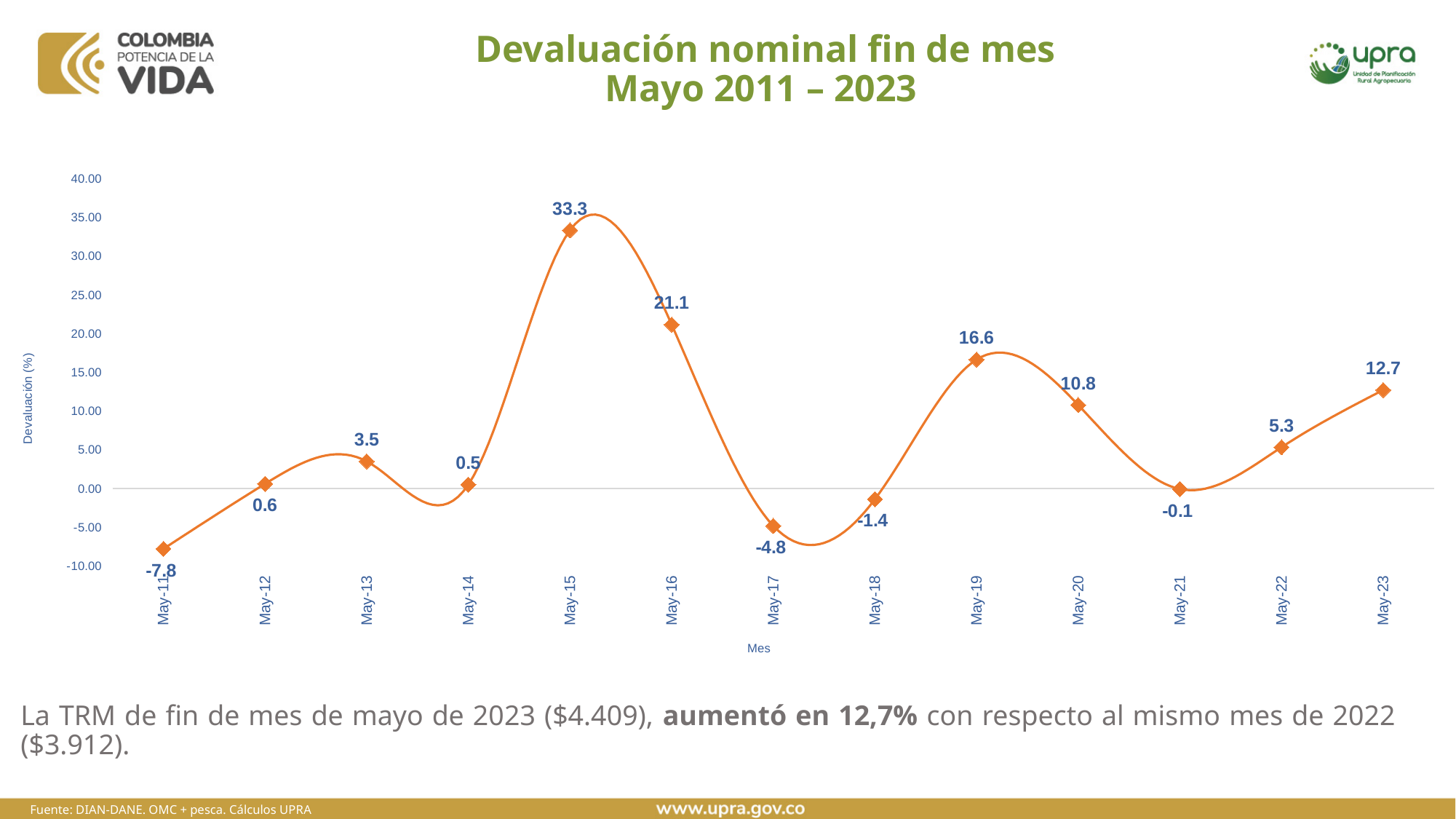
Which is larger, the value for May-19 or the value for May-20? May-19 Which month has the lowest value? May-11 What kind of chart is shown on the slide? Line chart Do the values rise or fall from May-21 to May-23? Rise How many data points are plotted on the chart? 13 What is the difference between the values for May-15 and May-16? 12.2 What is the title of the chart? Devaluación nominal fin de mes Mayo 2011 – 2023 What is the value for May-15? 33.3 Which month has the highest value? May-15 What is the value for May-21? -0.1 What is the value for May-17? -4.8 What is the value for May-23? 12.7